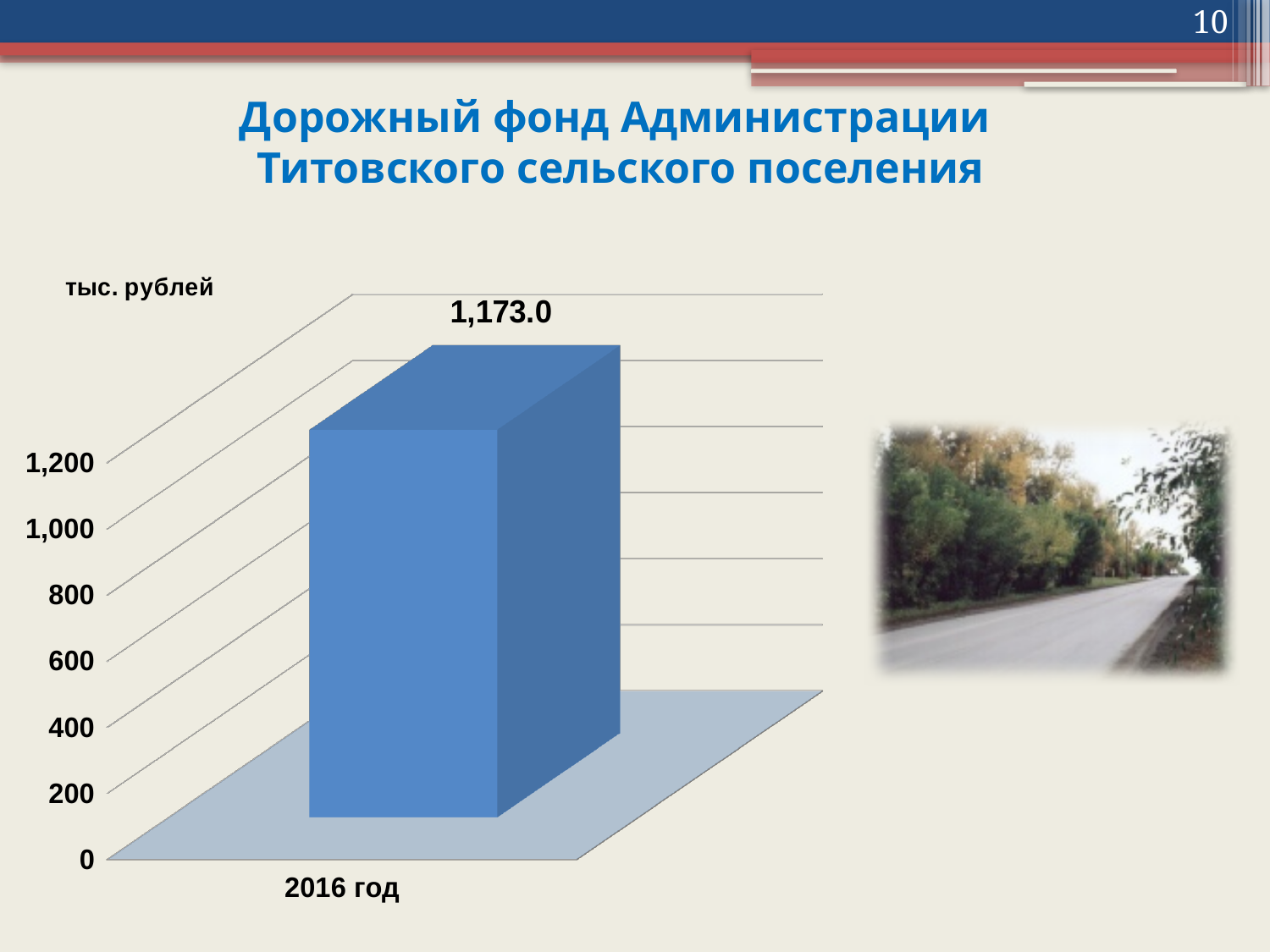
Which category label appears on the x axis of the chart? 2016 год What is the highest value shown on the vertical axis of the chart? 1,200 What unit is indicated for the values on the chart? тыс. рублей Is the value for 2016 год greater or less than 1,000? greater What is the value shown for 2016 год on the chart? 1,173.0 What kind of chart is shown on the slide? bar chart How many categories are plotted on the chart? 1 Is the value for 2016 год greater or less than 1,200? less